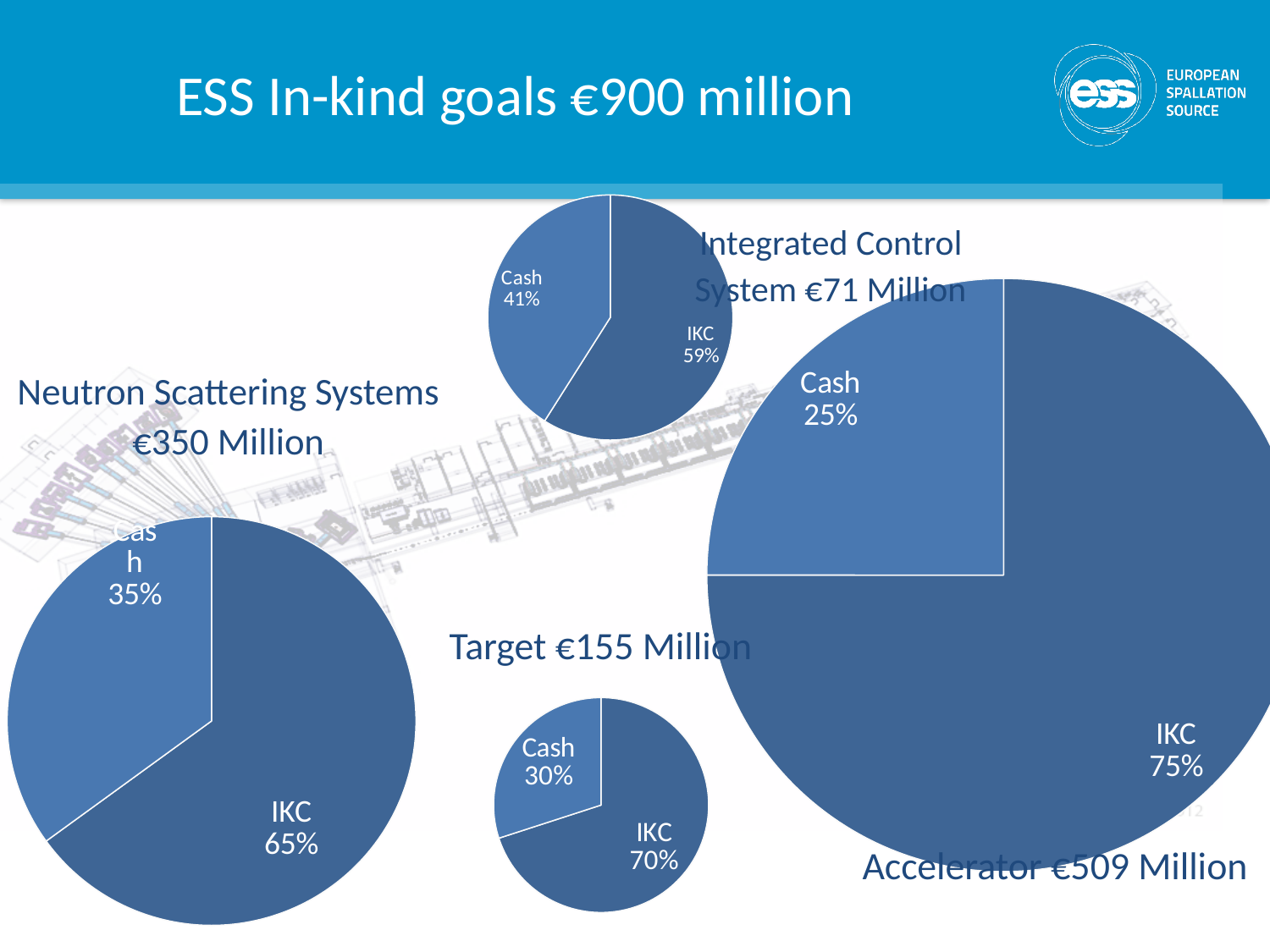
In the Accelerator €509 Million pie chart, what share is Cash? 25% In the Neutron Scattering Systems €350 Million pie chart, what share is Cash? 35% What kind of chart is used for the Integrated Control System €71 Million chart? Pie chart In the Target €155 Million pie chart, what share is IKC? 70% How many slices does the Neutron Scattering Systems €350 Million pie chart have? 2 In the Target €155 Million pie chart, which slice is larger, Cash or IKC? IKC In the Accelerator €509 Million pie chart, what is the difference between the IKC share and the Cash share? 50%